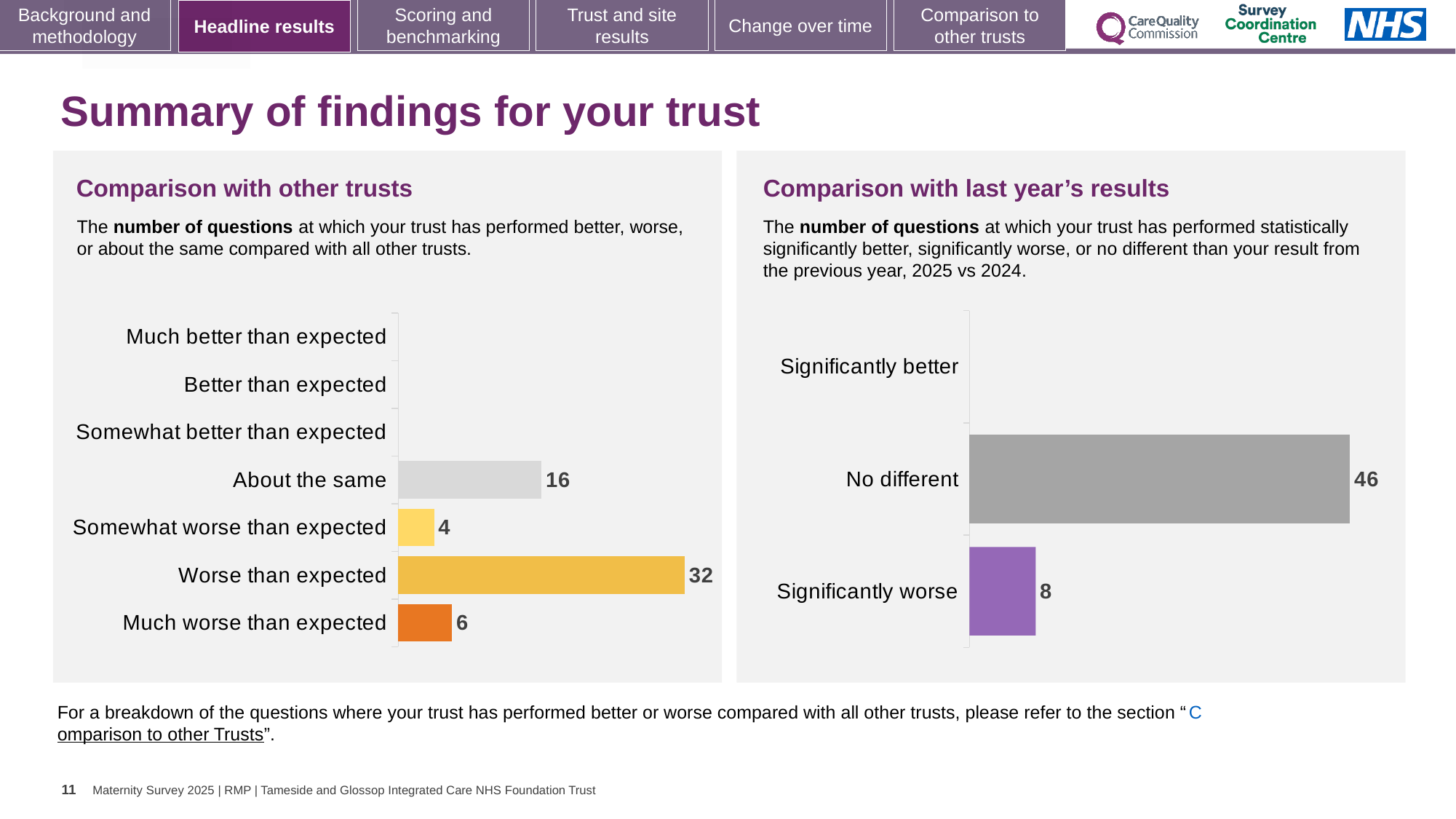
In the 'Comparison with last year's results' chart, what colour is the 'Significantly worse' bar? Purple In the 'Comparison with other trusts' chart, what is the difference between 'Worse than expected' and 'About the same'? 16 In the 'Comparison with other trusts' chart, what is the value for 'About the same'? 16 How many categories are listed in the 'Comparison with other trusts' chart? 7 In the 'Comparison with other trusts' chart, which is larger: 'Much worse than expected' or 'Somewhat worse than expected'? Much worse than expected What kind of chart is the 'Comparison with other trusts' chart? Bar chart In the 'Comparison with last year's results' chart, what is the value for 'No different'? 46 In the 'Comparison with other trusts' chart, which category has the highest value? Worse than expected In the 'Comparison with other trusts' chart, what is the value for 'Worse than expected'? 32 In the 'Comparison with last year's results' chart, what is the difference between 'No different' and 'Significantly worse'? 38 How many categories are listed in the 'Comparison with last year's results' chart? 3 In the 'Comparison with last year's results' chart, what is the value for 'Significantly worse'? 8